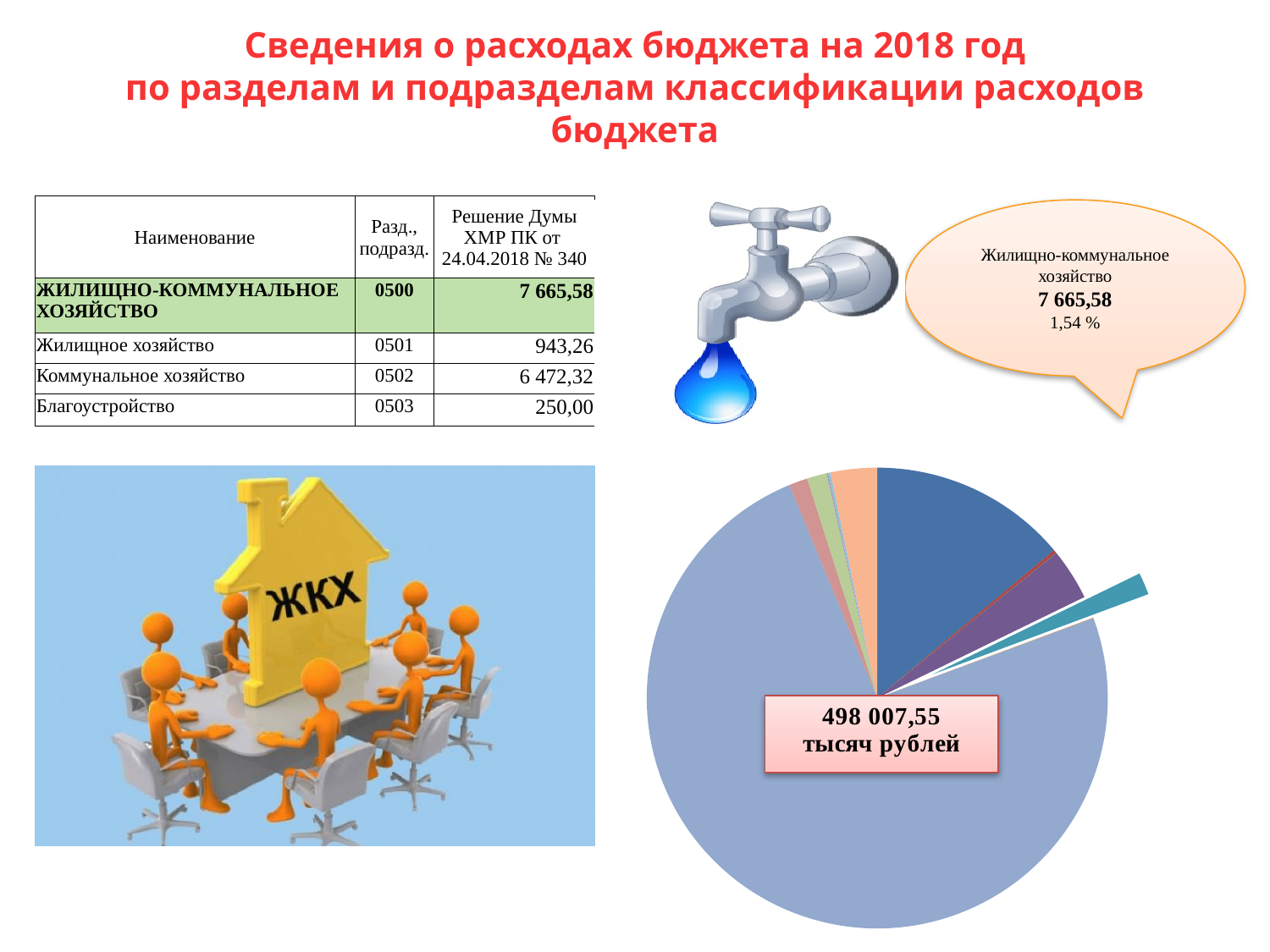
According to the callout on the slide, what share of the budget does Жилищно-коммунальное хозяйство represent? 1,54 % What total amount is printed in the box at the centre of the pie chart? 498 007,55 тысяч рублей What kind of chart is shown on the slide? pie chart Does the pie chart have a legend listing its series? no According to the callout on the slide, what is the amount for Жилищно-коммунальное хозяйство? 7 665,58 What colour is the slice that is pulled out (exploded) from the pie chart? teal